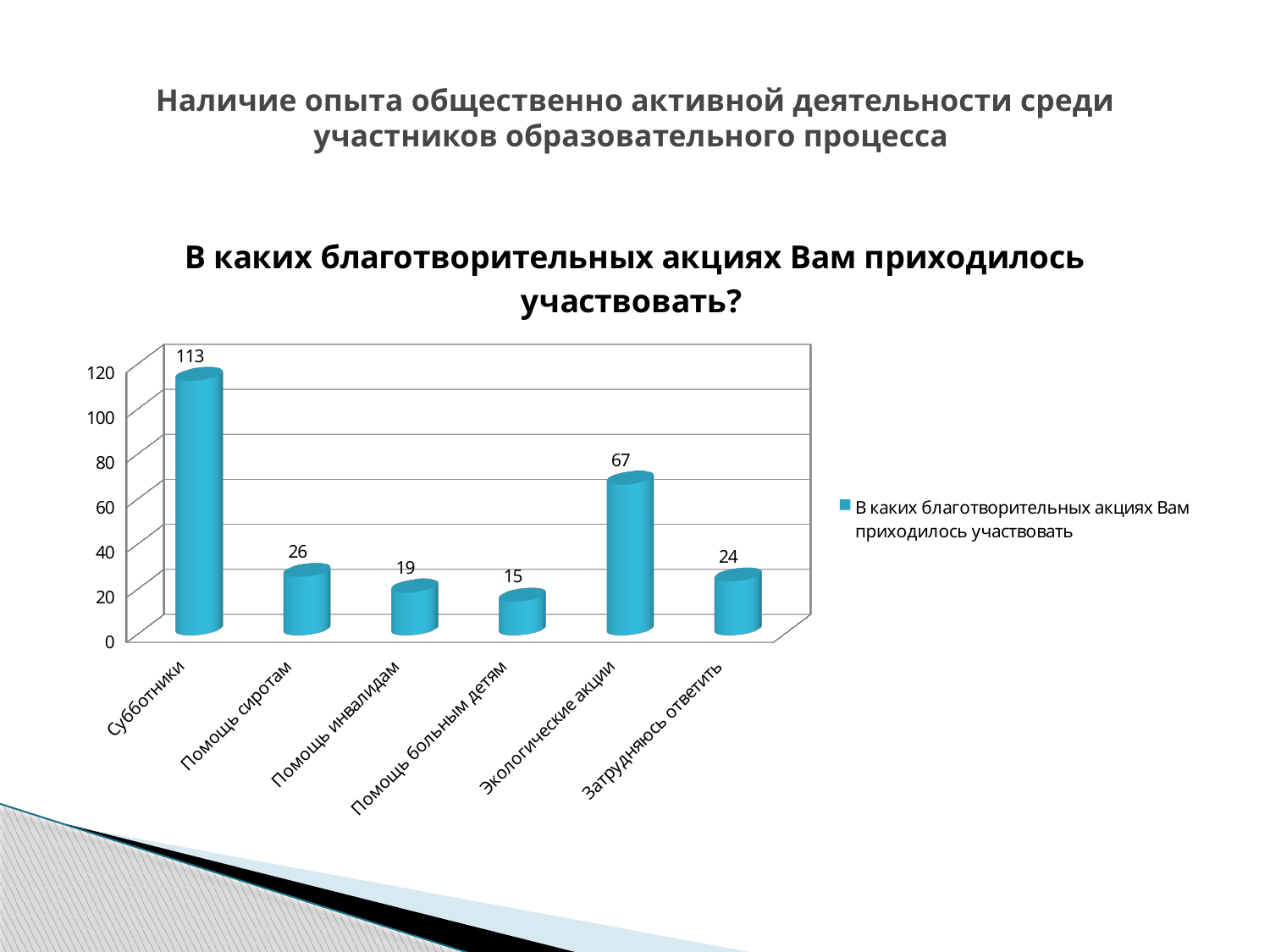
Which category has the lowest value? Помощь больным детям Is the value for Экологические акции greater or less than 60? greater What is the value for Помощь больным детям? 15 What is the value for Затрудняюсь ответить? 24 What is the title of the chart? В каких благотворительных акциях Вам приходилось участвовать? Which is larger, the value for Помощь сиротам or the value for Помощь инвалидам? Помощь сиротам What is the value for Субботники? 113 What kind of chart is shown on the slide? bar chart What is the difference between the values for Субботники and Экологические акции? 46 What is the value for Экологические акции? 67 Which category has the highest value? Субботники How many categories are shown on the x axis? 6